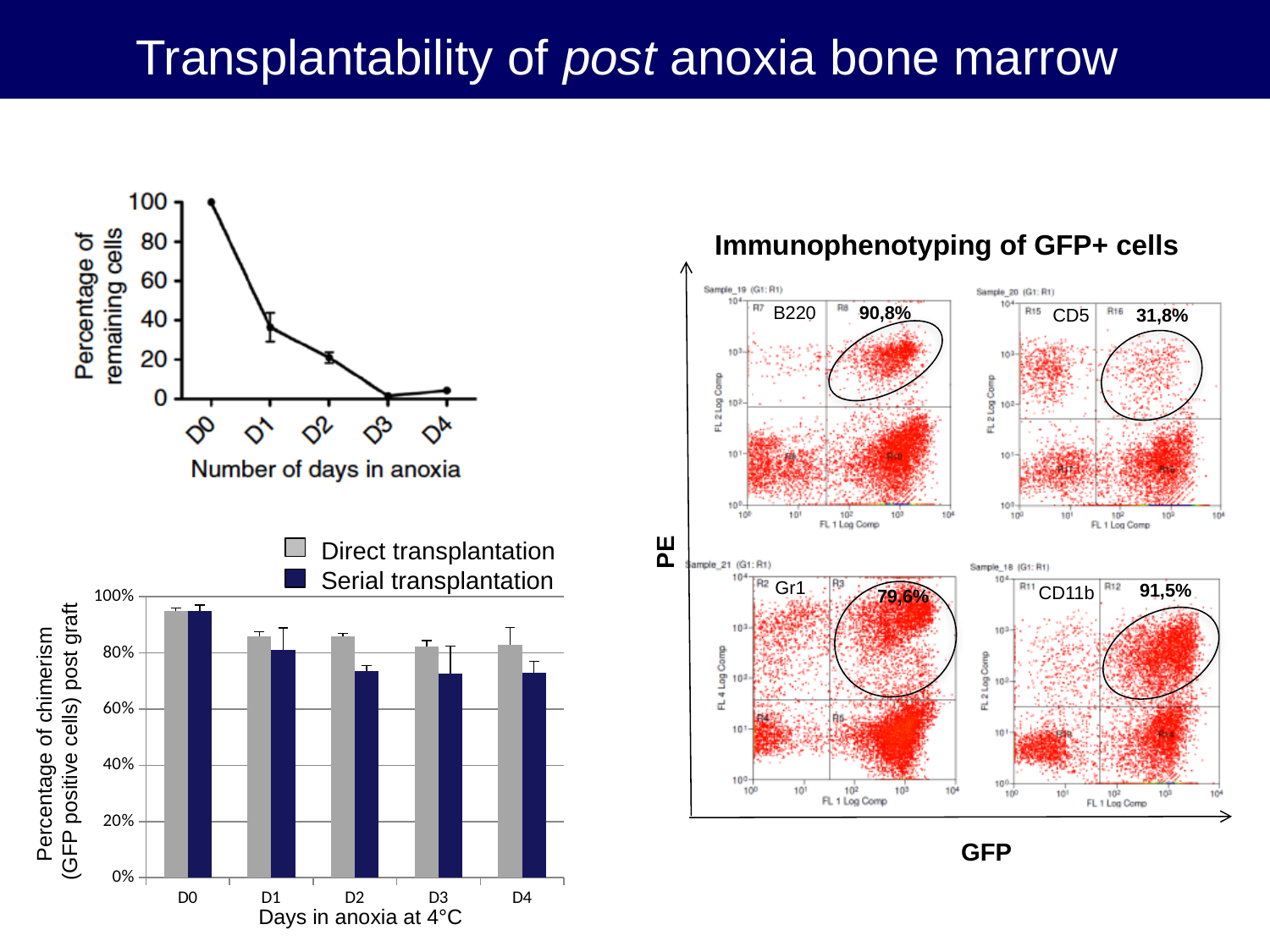
In the bar chart 'Days in anoxia at 4°C', which is larger at D2: Direct transplantation or Serial transplantation? Direct transplantation In the bar chart 'Days in anoxia at 4°C', is the Serial transplantation value at D2 greater or less than 80%? less In the line chart 'Number of days in anoxia', is the percentage of remaining cells at D1 greater or less than 60? less In the line chart 'Number of days in anoxia', what is the percentage of remaining cells at D0? 100 In 'Immunophenotyping of GFP+ cells', which marker has the lowest percentage? CD5 What kind of chart is the 'Days in anoxia at 4°C' chart at the bottom left? bar chart In the line chart 'Number of days in anoxia', how many days (points) are plotted on the x axis? 5 In the line chart 'Number of days in anoxia', is the percentage of remaining cells at D2 greater or less than 40? less In 'Immunophenotyping of GFP+ cells', what percentage is shown for B220? 90,8% In the bar chart 'Days in anoxia at 4°C', how many series does the legend list? 2 In 'Immunophenotyping of GFP+ cells', what is the difference between the CD11b and CD5 percentages? 59,7% In the line chart 'Number of days in anoxia', do the values rise or fall from D0 to D3? fall